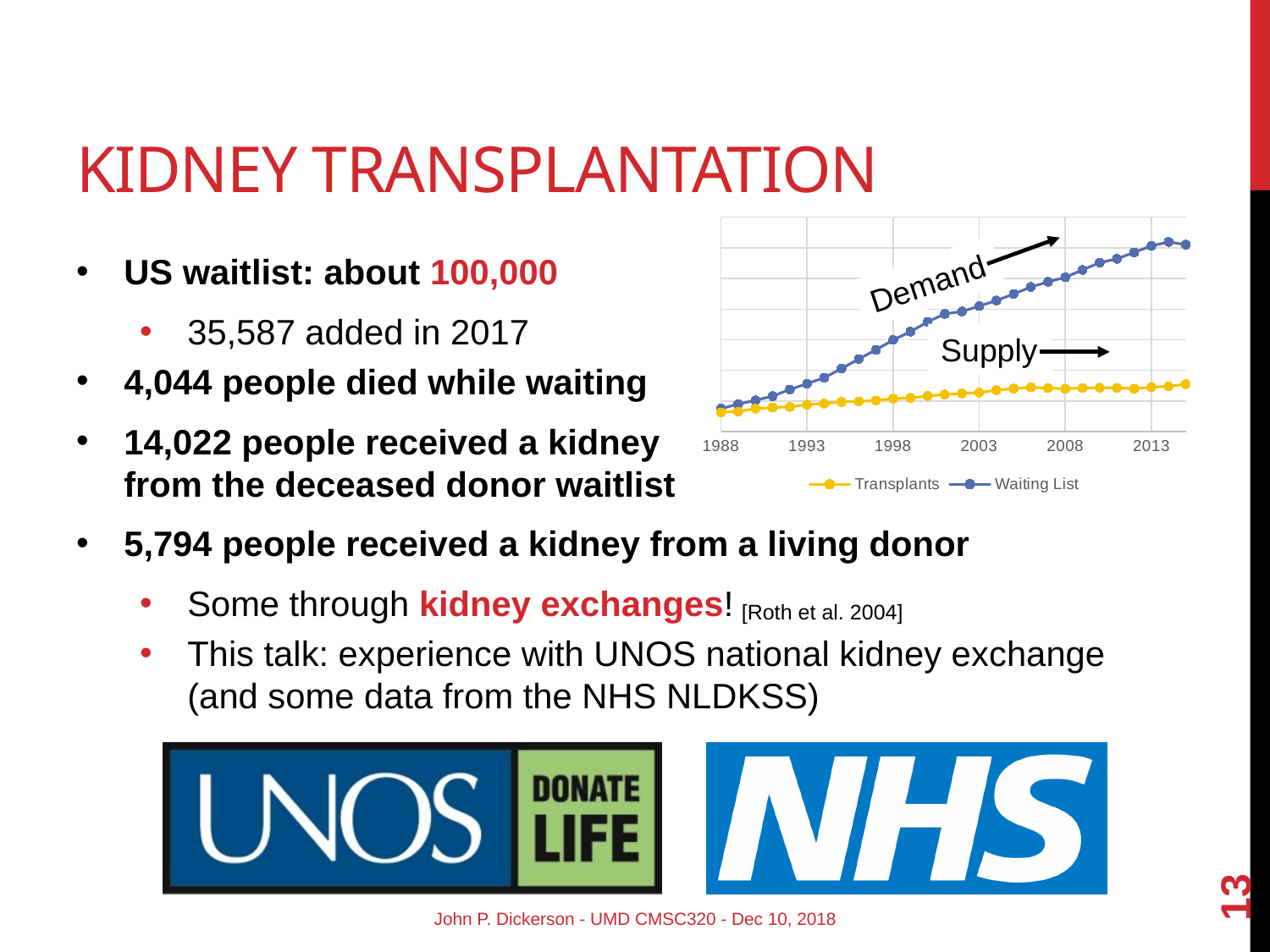
Does the Waiting List series rise or fall from 1988 to 2013? rise Does the Transplants series rise or fall over the years shown? rise What are the two series named in the chart's legend? Transplants and Waiting List How many series does the chart's legend list? 2 Which series grows faster over the period shown, Transplants or Waiting List? Waiting List What kind of chart is shown on the slide? line chart Which series is drawn in blue in the chart? Waiting List Which series is annotated as 'Demand' on the chart? Waiting List Which series is higher in 2013, Transplants or Waiting List? Waiting List